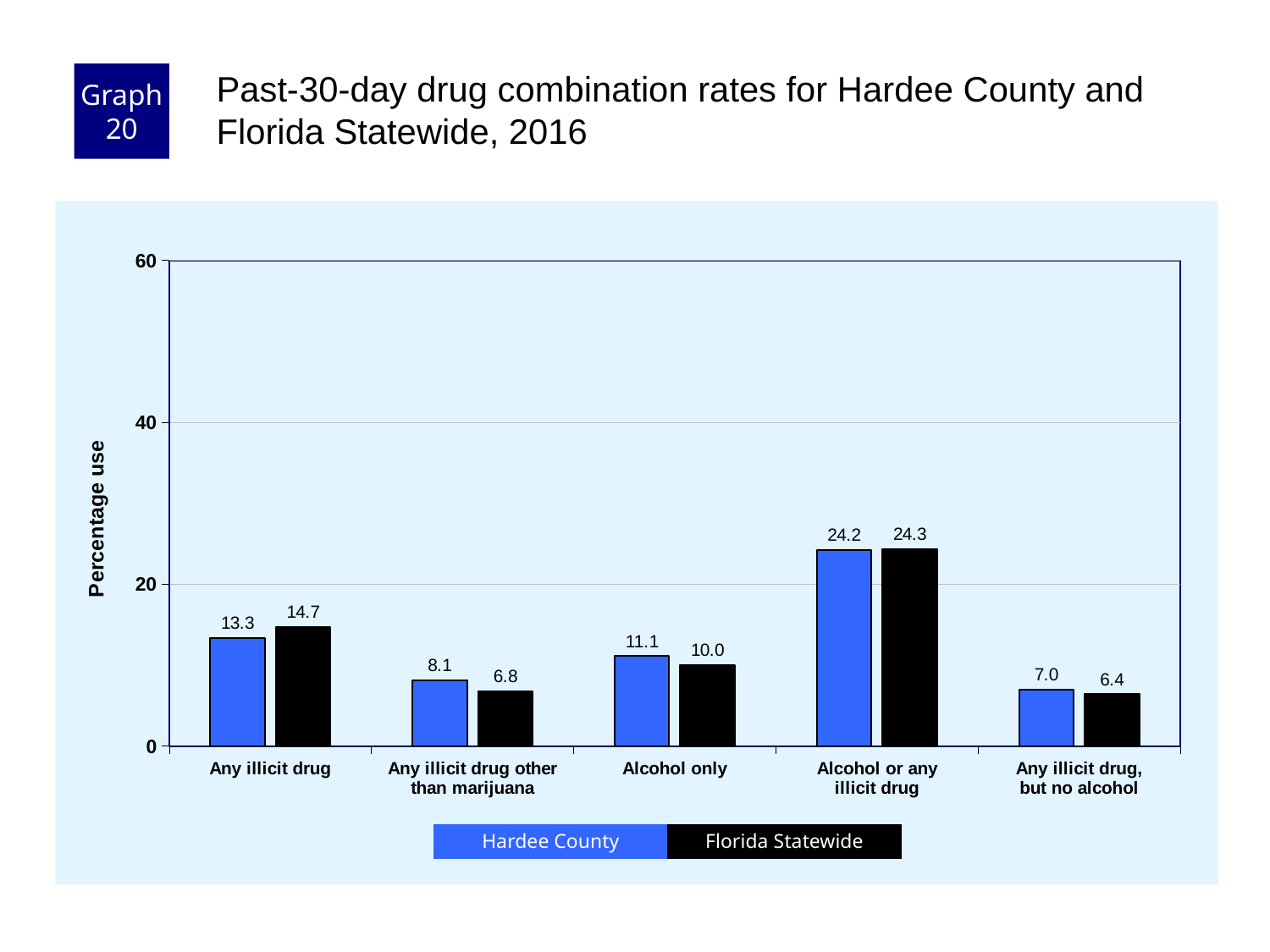
How many series does the legend list? 2 What is the Florida Statewide value for Any illicit drug, but no alcohol? 6.4 Is the Florida Statewide value for Alcohol or any illicit drug greater or less than 20? greater How many categories are shown on the x axis? 5 What is the difference between the Hardee County and Florida Statewide values for Any illicit drug other than marijuana? 1.3 For Alcohol only, which is larger: Hardee County or Florida Statewide? Hardee County What is the difference between the Florida Statewide and Hardee County values for Any illicit drug? 1.4 Which category has the lowest Florida Statewide value? Any illicit drug, but no alcohol What is the Florida Statewide value for Alcohol only? 10.0 Which category has the highest Hardee County value? Alcohol or any illicit drug What kind of chart is shown on the slide? Bar chart What is the Hardee County value for Any illicit drug? 13.3